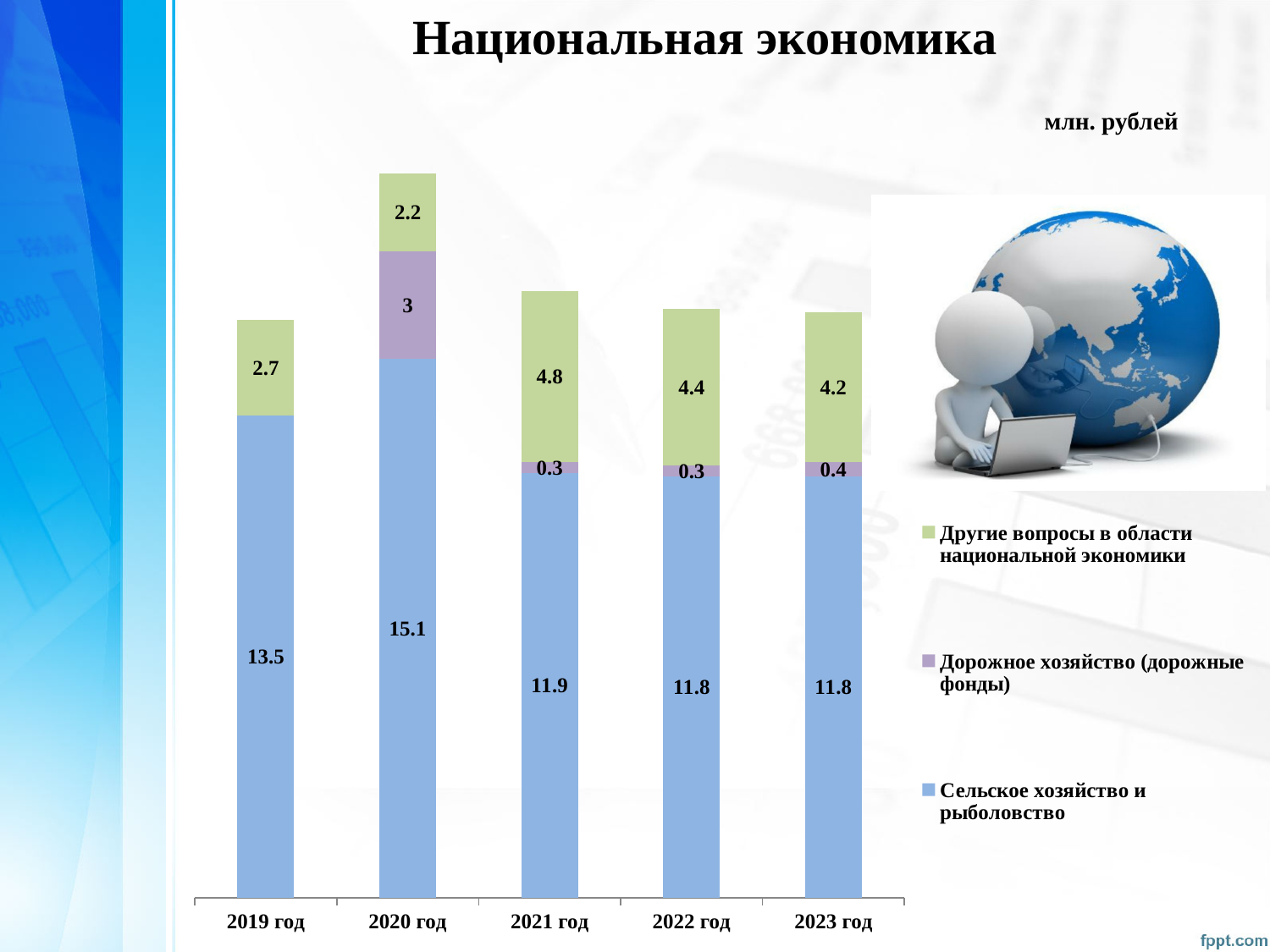
What is the difference between the Сельское хозяйство и рыболовство values for 2020 год and 2021 год? 3.2 How many series does the legend list? 3 Which is larger: the Другие вопросы в области национальной экономики value for 2022 год or for 2023 год? 2022 год What is the value for Дорожное хозяйство (дорожные фонды) in 2023 год? 0.4 How many years are shown on the x axis? 5 In which year is the value for Другие вопросы в области национальной экономики the lowest? 2020 год What kind of chart is shown on the slide? Stacked bar chart What is the value for Другие вопросы в области национальной экономики in 2021 год? 4.8 In which year is the value for Сельское хозяйство и рыболовство the highest? 2020 год What is the total of the stacked bar for 2020 год? 20.3 What is the value for Сельское хозяйство и рыболовство in 2020 год? 15.1 What is the total of the stacked bar for 2023 год? 16.4